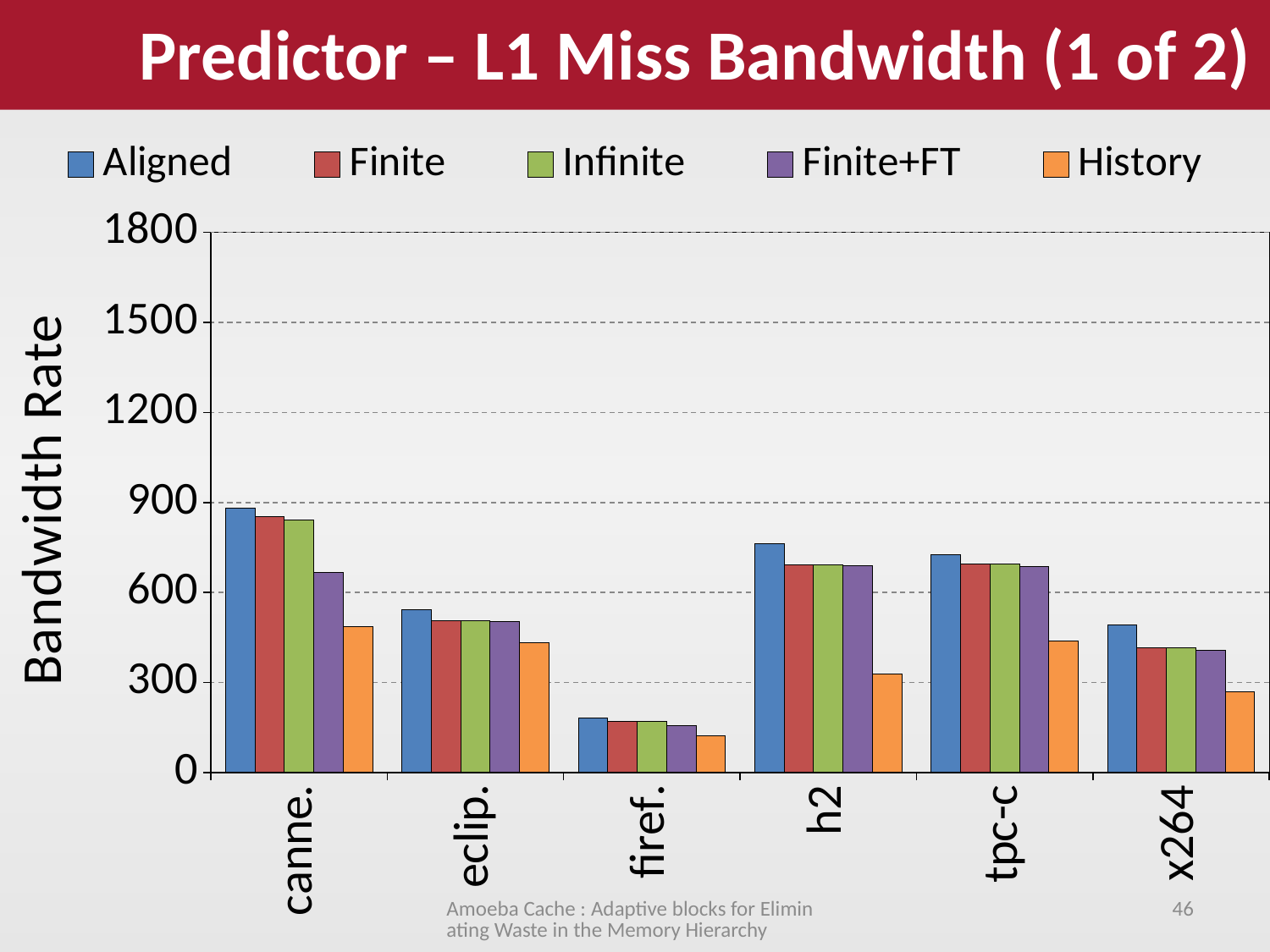
Is the Aligned value for h2 greater or less than 600? greater What kind of chart is shown on the slide? bar chart What is the title of the y axis? Bandwidth Rate For the h2 category, which series has the lowest value? History Is the Aligned value for firef. greater or less than 300? less Is the History value for canne. greater or less than 300? greater Which category has the highest Aligned value? canne. Which category has the lowest Aligned value? firef. How many series does the legend list? 5 How many categories are shown on the x axis? 6 Which is larger, the Aligned value for canne. or the Aligned value for x264? canne.